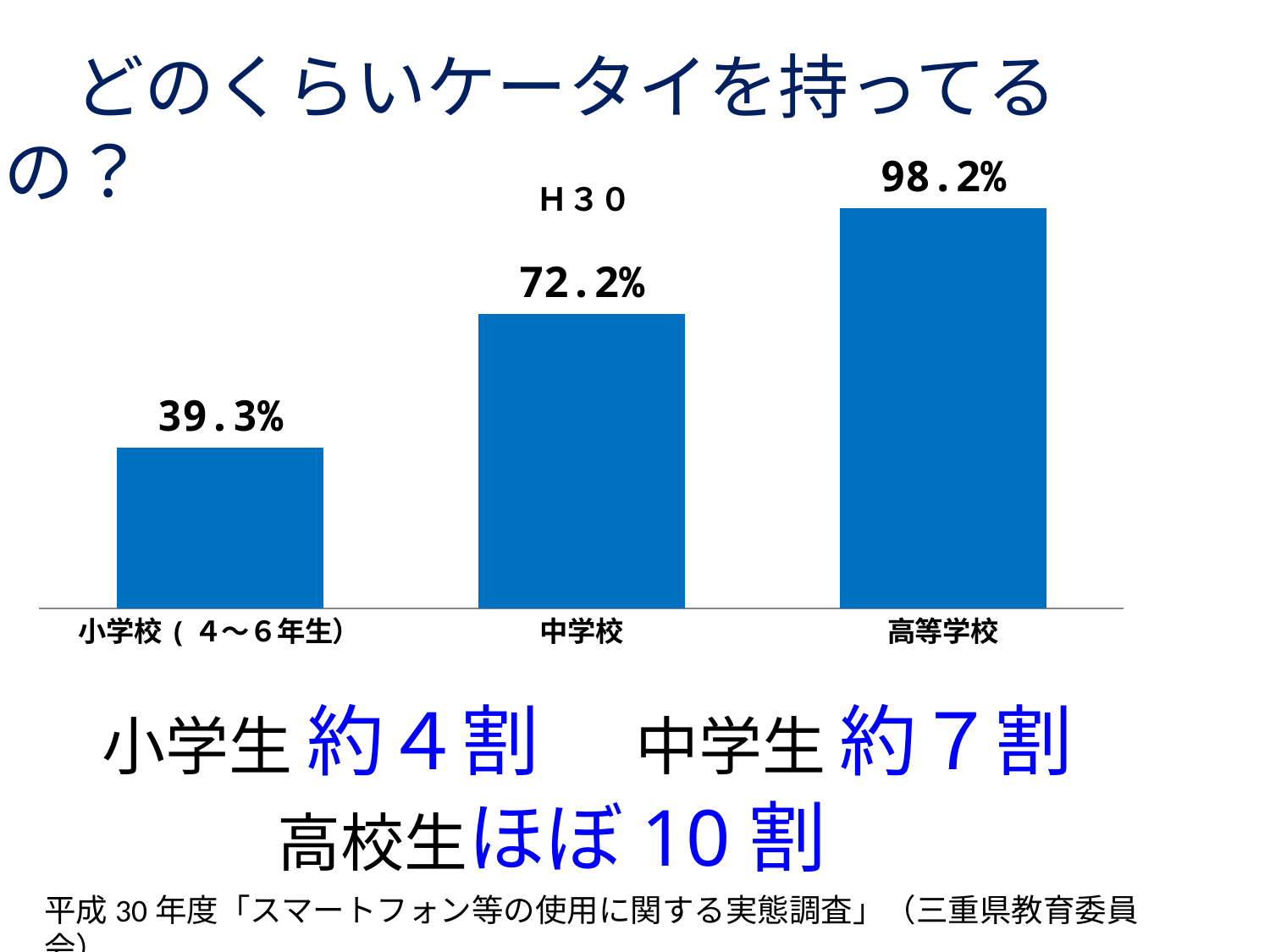
How many categories are shown in the chart? 3 What is the difference between the values for 高等学校 and 中学校? 26.0% What is the value for 高等学校? 98.2% What label is shown above the chart indicating the year? Ｈ３０ What is the value for 中学校? 72.2% What kind of chart is shown on the slide? bar chart Which category has the highest value? 高等学校 Do the values rise or fall from left to right along the x axis? rise What is the value for 小学校（４～６年生）? 39.3% Which is larger, the value for 中学校 or the value for 小学校（４～６年生）? 中学校 What is the difference between the values for 中学校 and 小学校（４～６年生）? 32.9% Which category has the lowest value? 小学校（４～６年生）